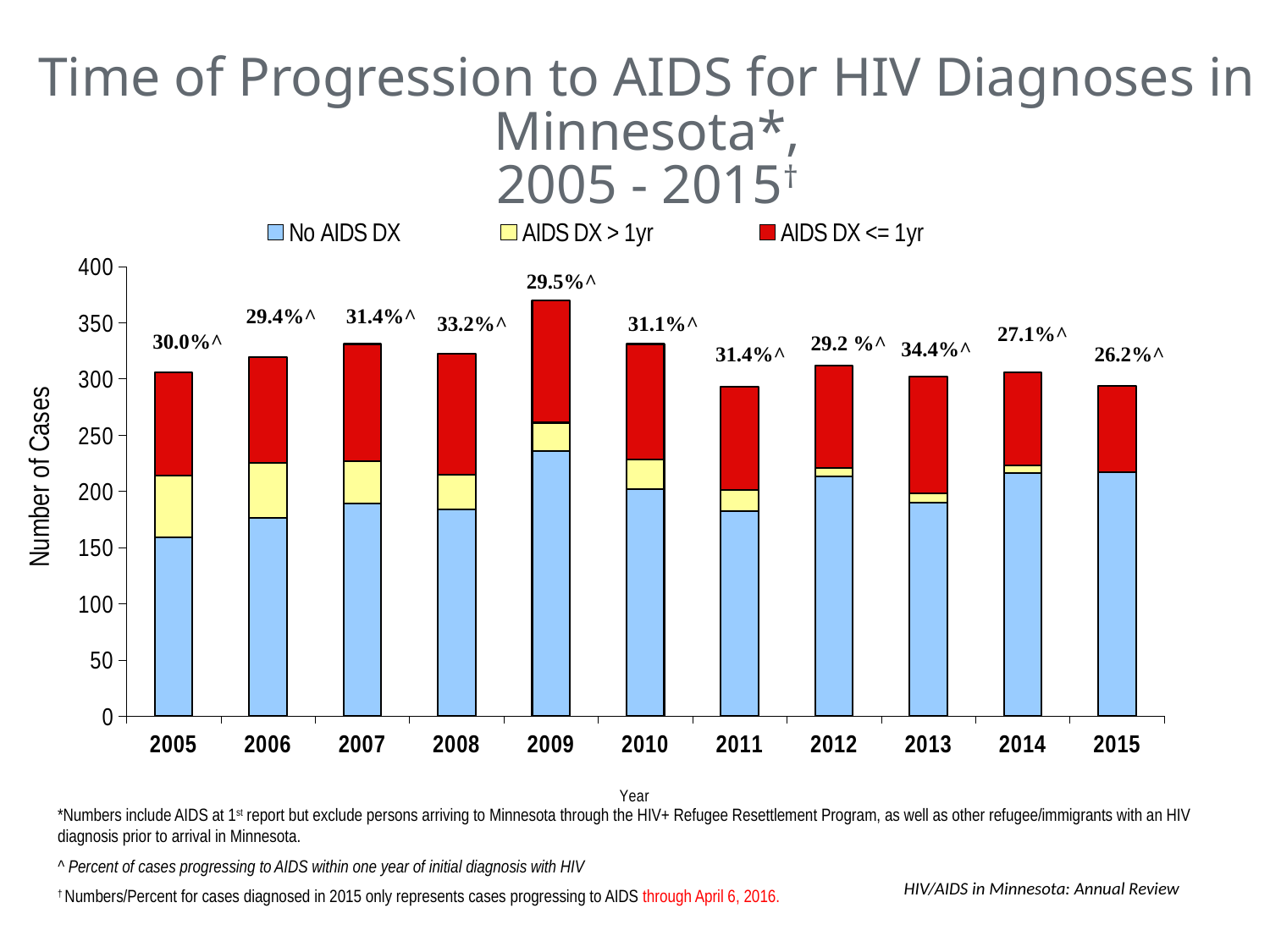
Is the total number of cases for 2011 greater or less than 300? less What kind of chart is shown on the slide? Stacked bar chart Which year has the highest percentage of cases progressing to AIDS within one year, according to the labels above the bars? 2013 Is the total number of cases for 2009 greater or less than 350? greater What percentage label is shown above the bar for 2005? 30.0%^ Which year has the larger percentage label, 2008 or 2010? 2008 What percentage label is shown above the bar for 2013? 34.4%^ How many years are shown on the x axis of the chart? 11 How many series does the legend list? 3 Which year has the lowest percentage of cases progressing to AIDS within one year, according to the labels above the bars? 2015 What is the difference in percentage points between the labels for 2013 (34.4%) and 2015 (26.2%)? 8.2 percentage points What percentage label is shown above the bar for 2015? 26.2%^